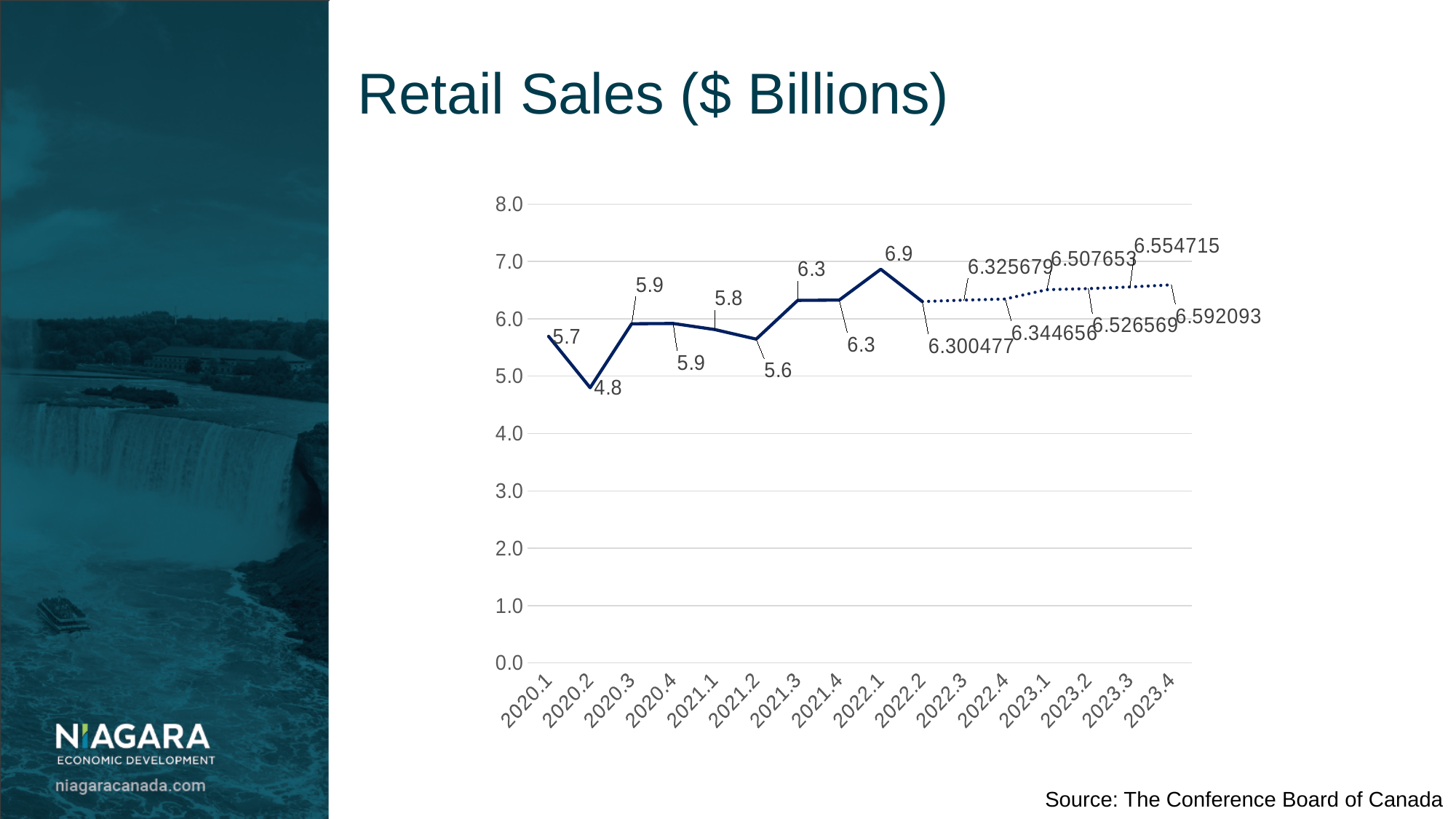
Do the retail sales values generally rise or fall from 2022.2 to 2023.4? Rise Which period has the highest retail sales value? 2022.1 What is the retail sales value for 2022.2? 6.300477 Which period has a larger retail sales value, 2021.2 or 2021.3? 2021.3 What is the retail sales value for 2020.2? 4.8 Which period has the lowest retail sales value? 2020.2 What is the retail sales value for 2023.4? 6.592093 What is the retail sales value for 2022.1? 6.9 What is the title of the chart? Retail Sales ($ Billions) What type of chart is shown on the slide? Line chart What is the difference between the retail sales values for 2022.1 and 2020.2? 2.1 How many periods are plotted on the x axis? 16